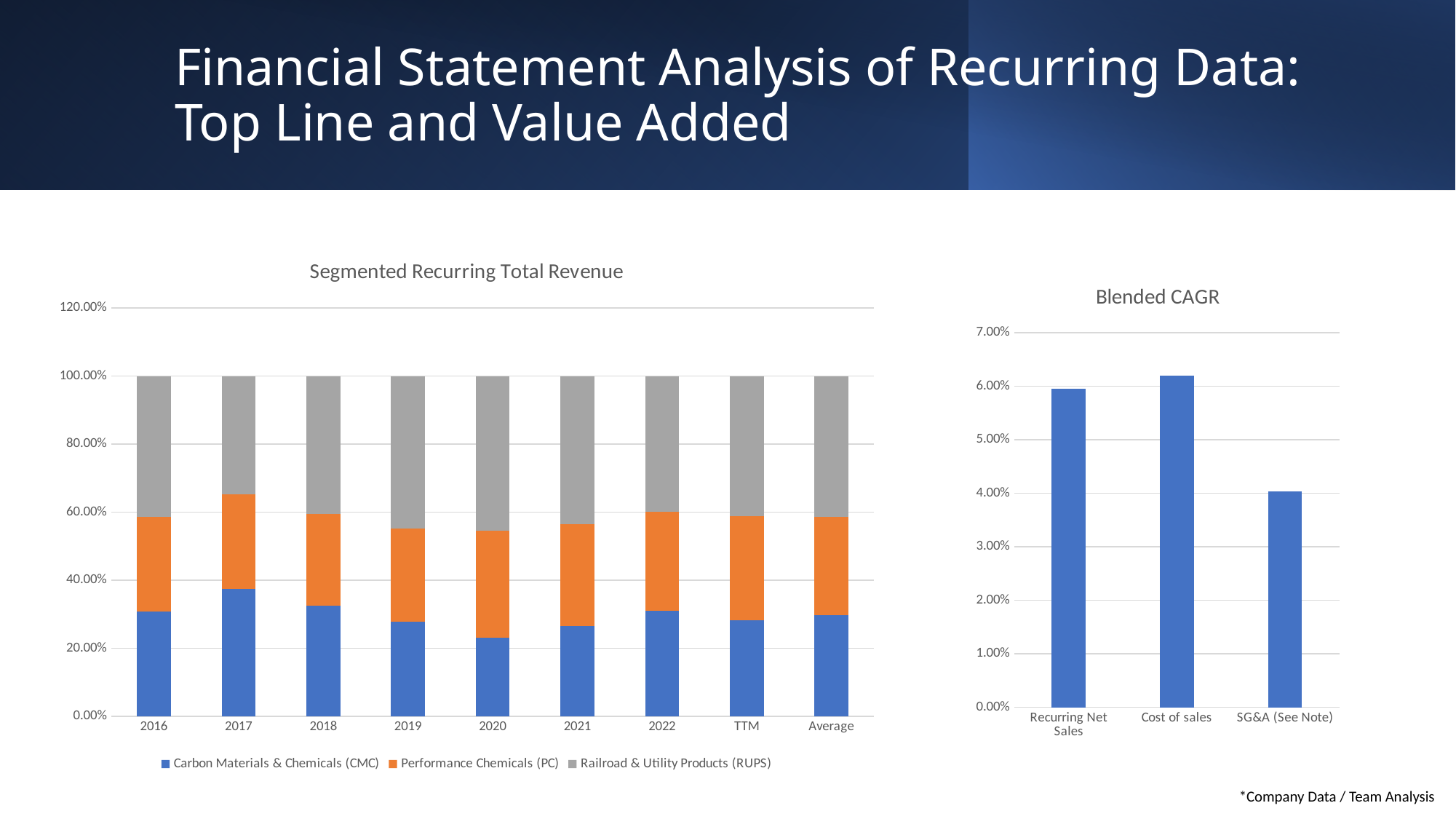
What type of chart is the "Segmented Recurring Total Revenue" chart? Stacked bar chart How many bars are shown in the "Blended CAGR" chart? 3 How many series does the legend of the "Segmented Recurring Total Revenue" chart list? 3 In the "Segmented Recurring Total Revenue" chart, what is the total height of the stacked bar for 2019? 100.00% In the "Blended CAGR" chart, which category has the lowest value? SG&A (See Note) How many categories are shown on the x axis of the "Segmented Recurring Total Revenue" chart? 9 In the "Segmented Recurring Total Revenue" chart, which series is shown in grey? Railroad & Utility Products (RUPS) In the "Blended CAGR" chart, which category has the highest value? Cost of sales In the "Segmented Recurring Total Revenue" chart, which year has the smallest Carbon Materials & Chemicals (CMC) share? 2020 In the "Segmented Recurring Total Revenue" chart, which year has the largest Carbon Materials & Chemicals (CMC) share? 2017 In the "Blended CAGR" chart, is the value for SG&A (See Note) greater or less than 5.00%? less In the "Segmented Recurring Total Revenue" chart, is the Carbon Materials & Chemicals (CMC) value for 2017 greater or less than 40.00%? less